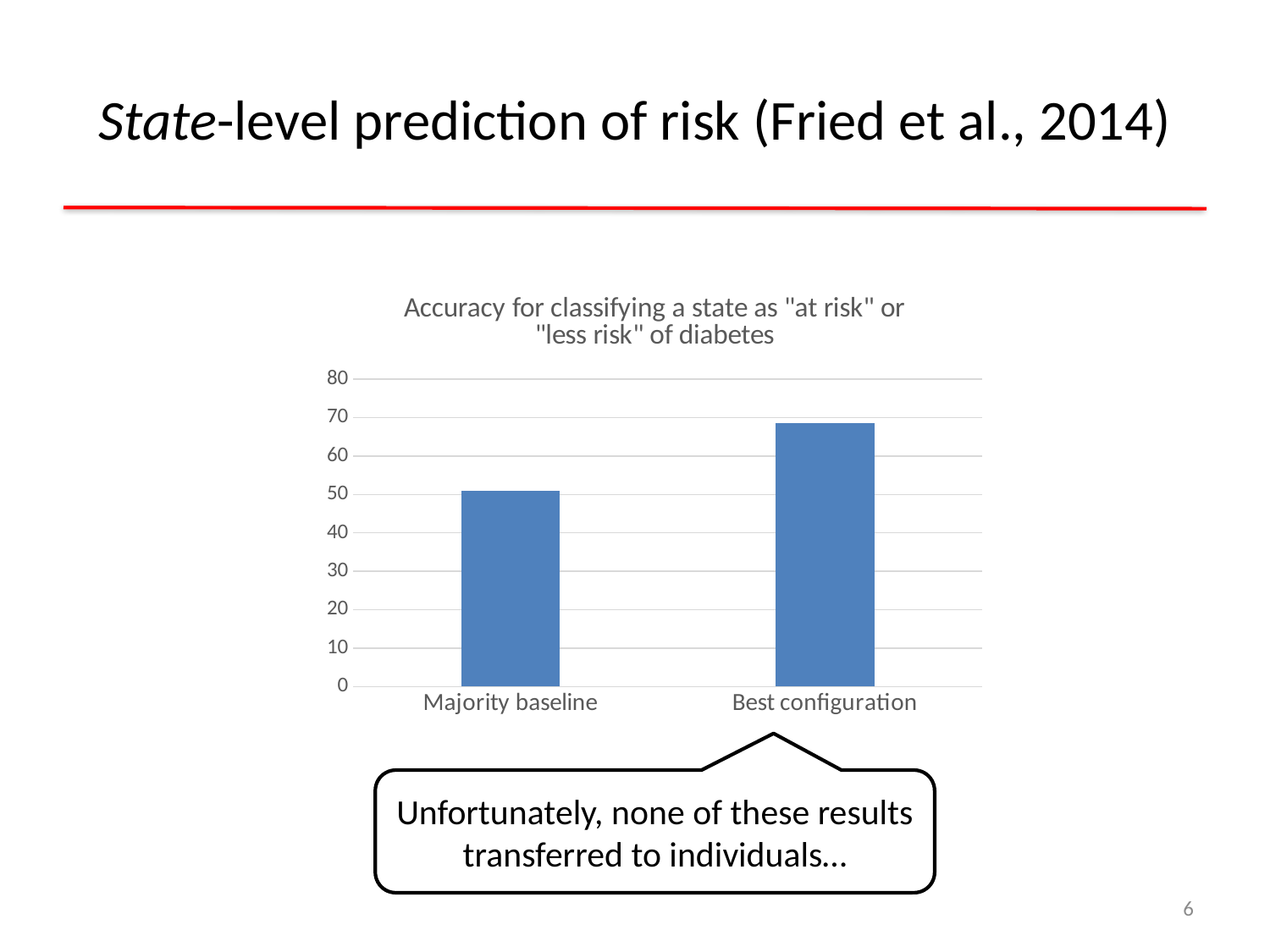
Do the bar values rise or fall from Majority baseline to Best configuration? rise Which category has the highest bar in the chart? Best configuration How many categories are shown on the x axis of the chart? 2 Which is larger, the value for Majority baseline or the value for Best configuration? Best configuration Which category has the lowest bar in the chart? Majority baseline Is the value for Majority baseline greater or less than 40? greater What is the highest value shown on the chart's vertical axis? 80 What is the title of the chart? Accuracy for classifying a state as "at risk" or "less risk" of diabetes Is the value for Best configuration greater or less than 60? greater What kind of chart is shown on the slide? bar chart Is the value for Majority baseline greater or less than 60? less